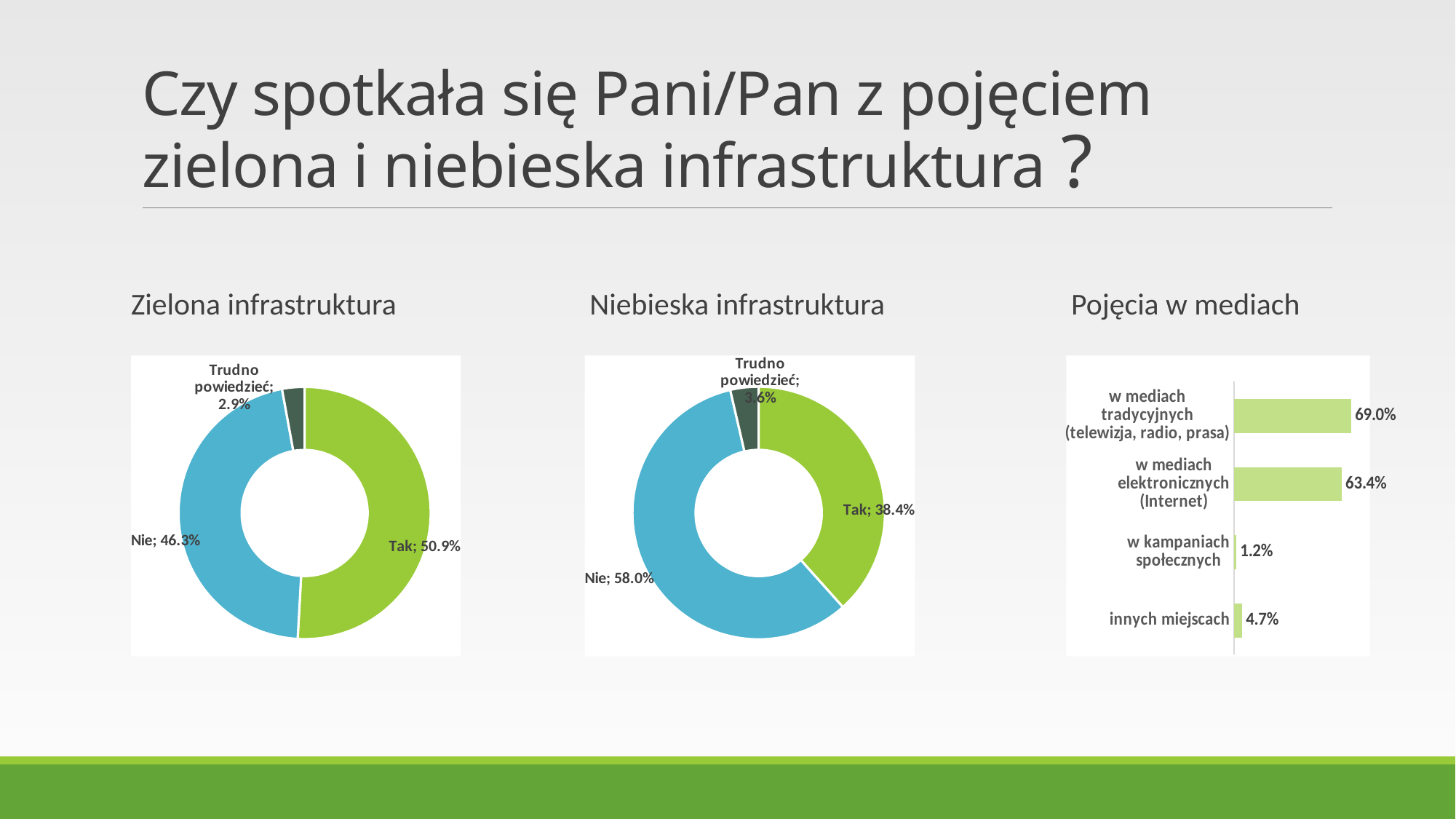
In the 'Zielona infrastruktura' chart, what is the value for 'Nie'? 46.3% In the 'Niebieska infrastruktura' chart, which category has the largest share? Nie In the 'Niebieska infrastruktura' chart, what is the value for 'Trudno powiedzieć'? 3.6% In the 'Zielona infrastruktura' chart, what is the value for 'Tak'? 50.9% In the 'Pojęcia w mediach' chart, what is the difference between 'w mediach tradycyjnych (telewizja, radio, prasa)' and 'w mediach elektronicznych (Internet)'? 5.6% In the 'Zielona infrastruktura' chart, which category has the smallest share? Trudno powiedzieć What kind of chart is the 'Pojęcia w mediach' chart? Bar chart In the 'Pojęcia w mediach' chart, which category has the lowest value? w kampaniach społecznych In the 'Pojęcia w mediach' chart, what is the value for 'w mediach elektronicznych (Internet)'? 63.4% How many categories does the 'Pojęcia w mediach' chart show? 4 In the 'Niebieska infrastruktura' chart, what is the difference between 'Nie' and 'Tak'? 19.6% In the 'Zielona infrastruktura' chart, which is larger, 'Tak' or 'Nie'? Tak